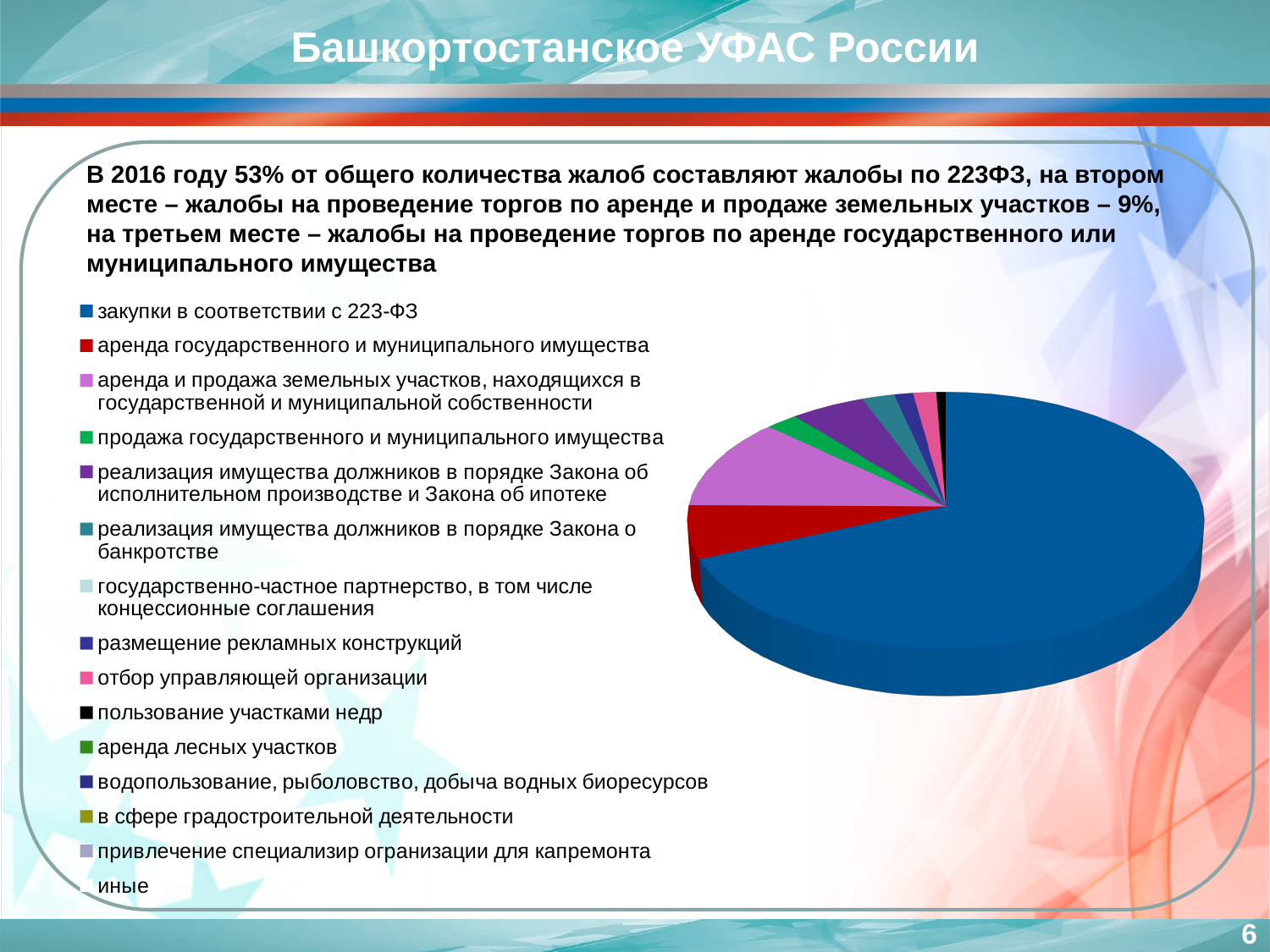
Which slice is larger: 'аренда и продажа земельных участков, находящихся в государственной и муниципальной собственности' or 'аренда государственного и муниципального имущества'? аренда и продажа земельных участков, находящихся в государственной и муниципальной собственности What kind of chart is shown on the slide? pie chart How many categories does the legend list? 15 Which slice is larger: 'закупки в соответствии с 223-ФЗ' or 'аренда государственного и муниципального имущества'? закупки в соответствии с 223-ФЗ Is the share of 'закупки в соответствии с 223-ФЗ' greater or less than 50%? greater Which category has the largest slice of the pie? закупки в соответствии с 223-ФЗ What colour is the slice for 'закупки в соответствии с 223-ФЗ'? blue What share of complaints concern tenders for lease and sale of land plots, according to the slide? 9% What share of the total complaints in 2016 do complaints under 223-ФЗ make up, according to the slide? 53% Which category ranks second by share of complaints, according to the slide text? жалобы на проведение торгов по аренде и продаже земельных участков Is the share of 'аренда государственного и муниципального имущества' greater or less than 25%? less